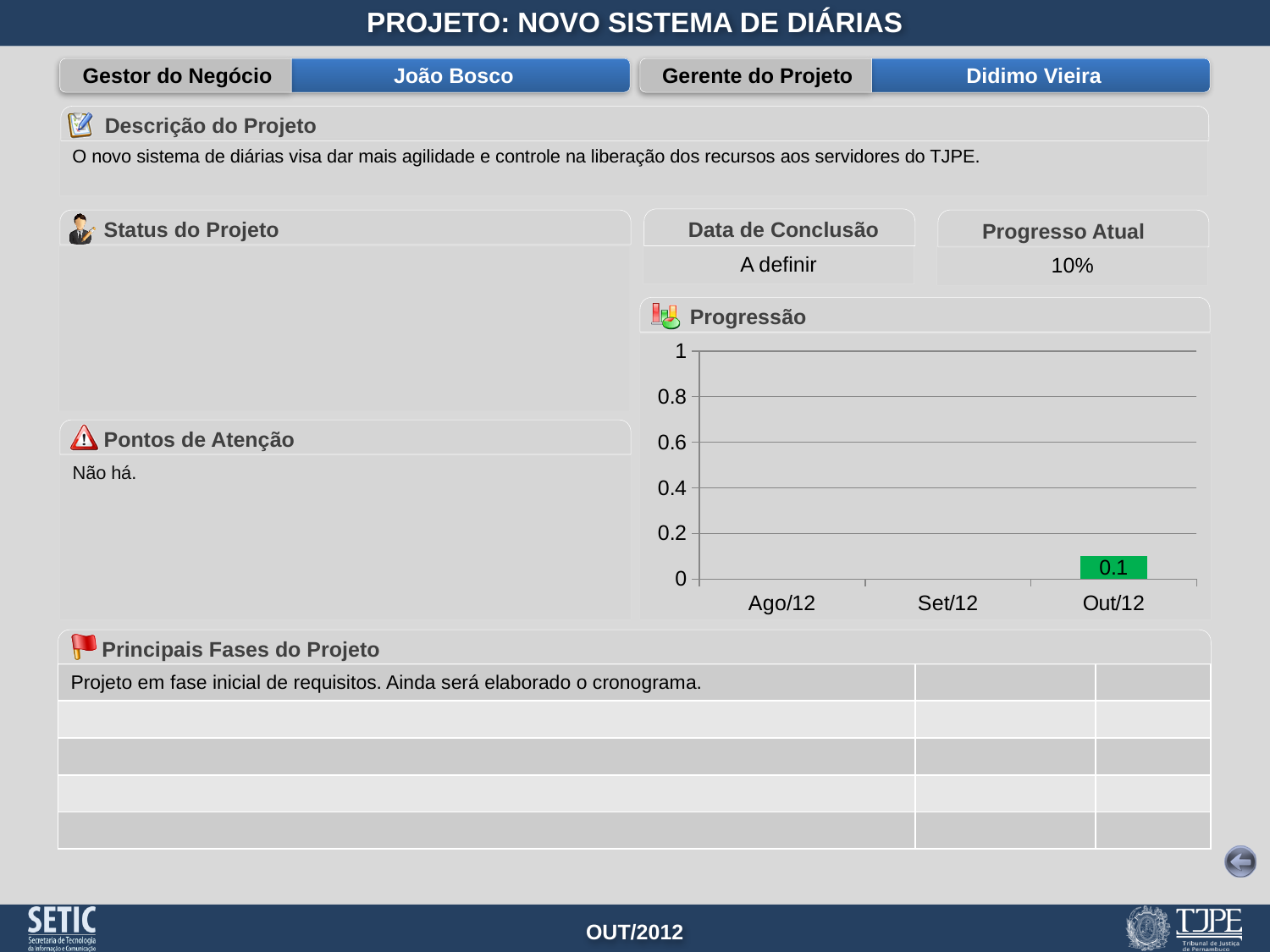
What is the title of the chart on the slide? Progressão How many categories are shown on the x axis of the Progressão chart? 3 What is the value shown for Out/12 in the Progressão chart? 0.1 Which category has the highest value in the Progressão chart? Out/12 What is the highest value marked on the y axis of the Progressão chart? 1 How many categories in the Progressão chart have a visible bar? 1 What is the first category on the x axis of the Progressão chart? Ago/12 In the Progressão chart, which is larger: the value for Set/12 or the value for Out/12? Out/12 Is the value for Out/12 in the Progressão chart greater or less than 0.6? less What kind of chart is the Progressão chart? bar chart Is the value for Out/12 in the Progressão chart greater or less than 0.2? less